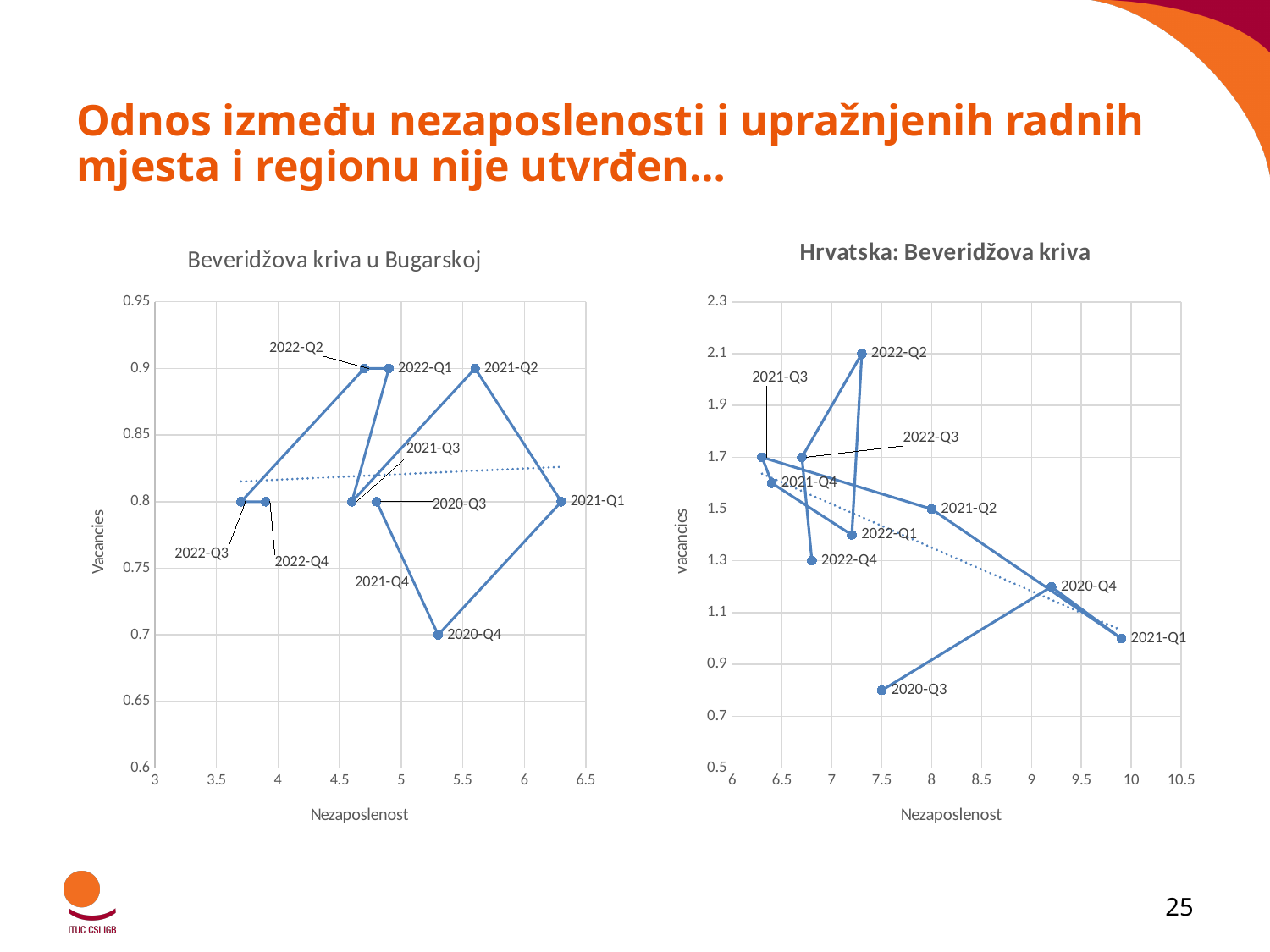
What is the x-axis title of the 'Hrvatska: Beveridžova kriva' chart? Nezaposlenost In the 'Beveridžova kriva u Bugarskoj' chart, how many quarterly data points are plotted? 10 In the 'Hrvatska: Beveridžova kriva' chart, what is the difference in vacancies between 2022-Q2 and 2022-Q4? 0.8 In the 'Hrvatska: Beveridžova kriva' chart, is the unemployment value for 2021-Q1 greater or less than 9.5? greater In the 'Beveridžova kriva u Bugarskoj' chart, what is the vacancies value for 2020-Q4? 0.7 What kind of chart is the 'Beveridžova kriva u Bugarskoj' chart? scatter chart In the 'Hrvatska: Beveridžova kriva' chart, what is the vacancies value for 2022-Q2? 2.1 In the 'Beveridžova kriva u Bugarskoj' chart, which quarter has the highest unemployment (Nezaposlenost) value? 2021-Q1 In the 'Hrvatska: Beveridžova kriva' chart, which quarter has the lowest vacancies value? 2020-Q3 In the 'Beveridžova kriva u Bugarskoj' chart, which quarter has the lowest vacancies value? 2020-Q4 In the 'Hrvatska: Beveridžova kriva' chart, how many quarterly data points are plotted? 10 In the 'Beveridžova kriva u Bugarskoj' chart, is the unemployment value for 2020-Q4 greater or less than 5? greater